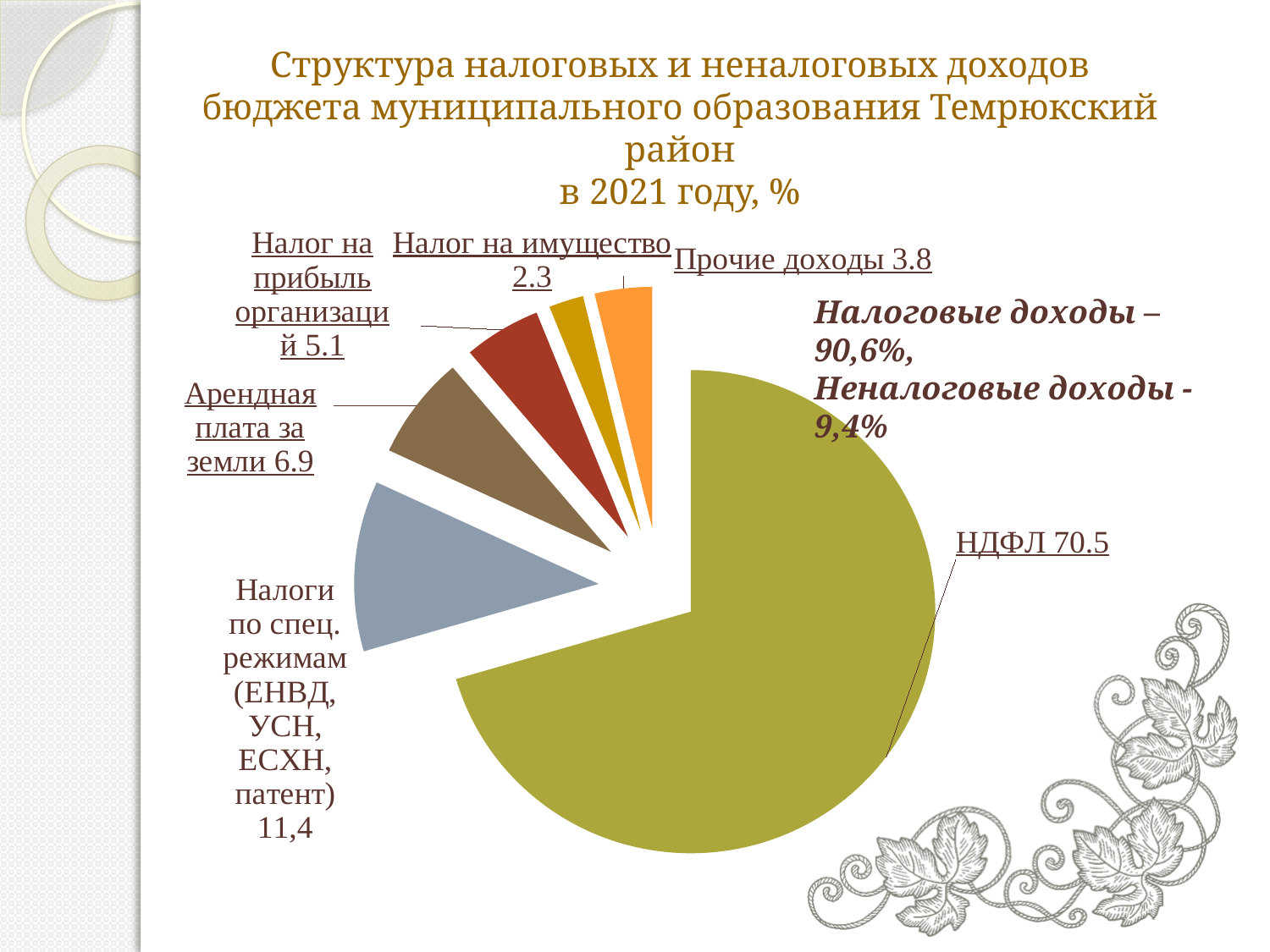
How many slices does the pie chart have? 6 What is the value for Арендная плата за земли? 6.9 What is the value for Налог на имущество? 2.3 What is the difference between the values for НДФЛ and Налоги по спец. режимам (ЕНВД, УСН, ЕСХН, патент)? 59.1 Which category has the smallest slice of the pie? Налог на имущество According to the text next to the chart, what share of revenues is Налоговые доходы? 90,6% Which category has the largest slice of the pie? НДФЛ Which is larger, Арендная плата за земли or Налог на прибыль организаций? Арендная плата за земли What is the value for НДФЛ? 70.5 What kind of chart is shown on the slide? pie chart What is the value for Налоги по спец. режимам (ЕНВД, УСН, ЕСХН, патент)? 11,4 What is the value for Прочие доходы? 3.8